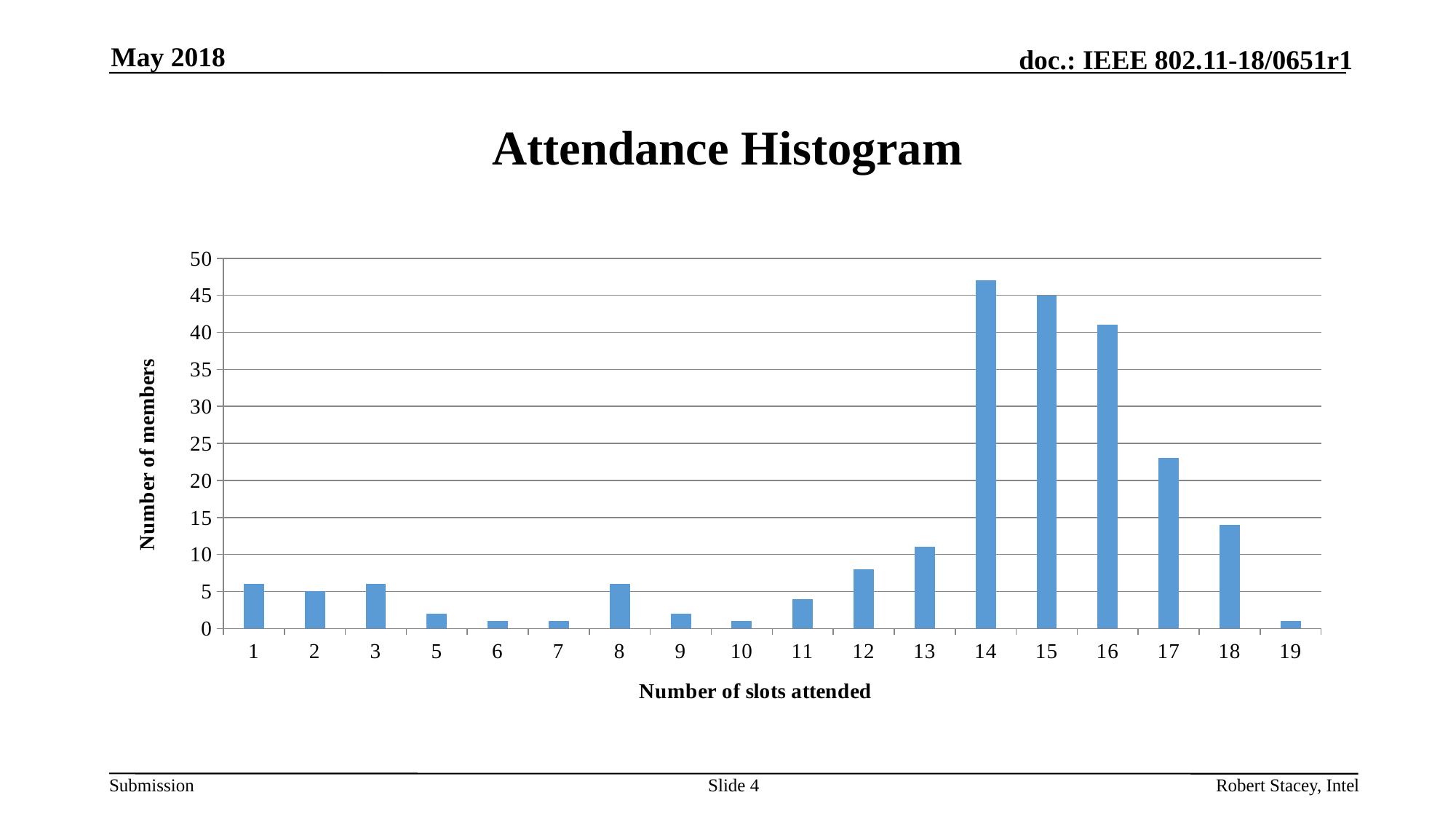
Which number of slots attended has the highest number of members? 14 What kind of chart is shown on the slide? bar chart Is the number of members for 17 slots attended greater or less than 25? less Which has more members: 13 slots attended or 18 slots attended? 18 slots attended Is the number of members for 14 slots attended greater or less than 45? greater What is the title of the chart? Attendance Histogram How many categories (number of slots attended) are shown on the x axis? 18 What is the label of the vertical axis? Number of members What is the number of members for 2 slots attended? 5 Do the values rise or fall from 14 slots attended to 19 slots attended? fall What is the number of members for 15 slots attended? 45